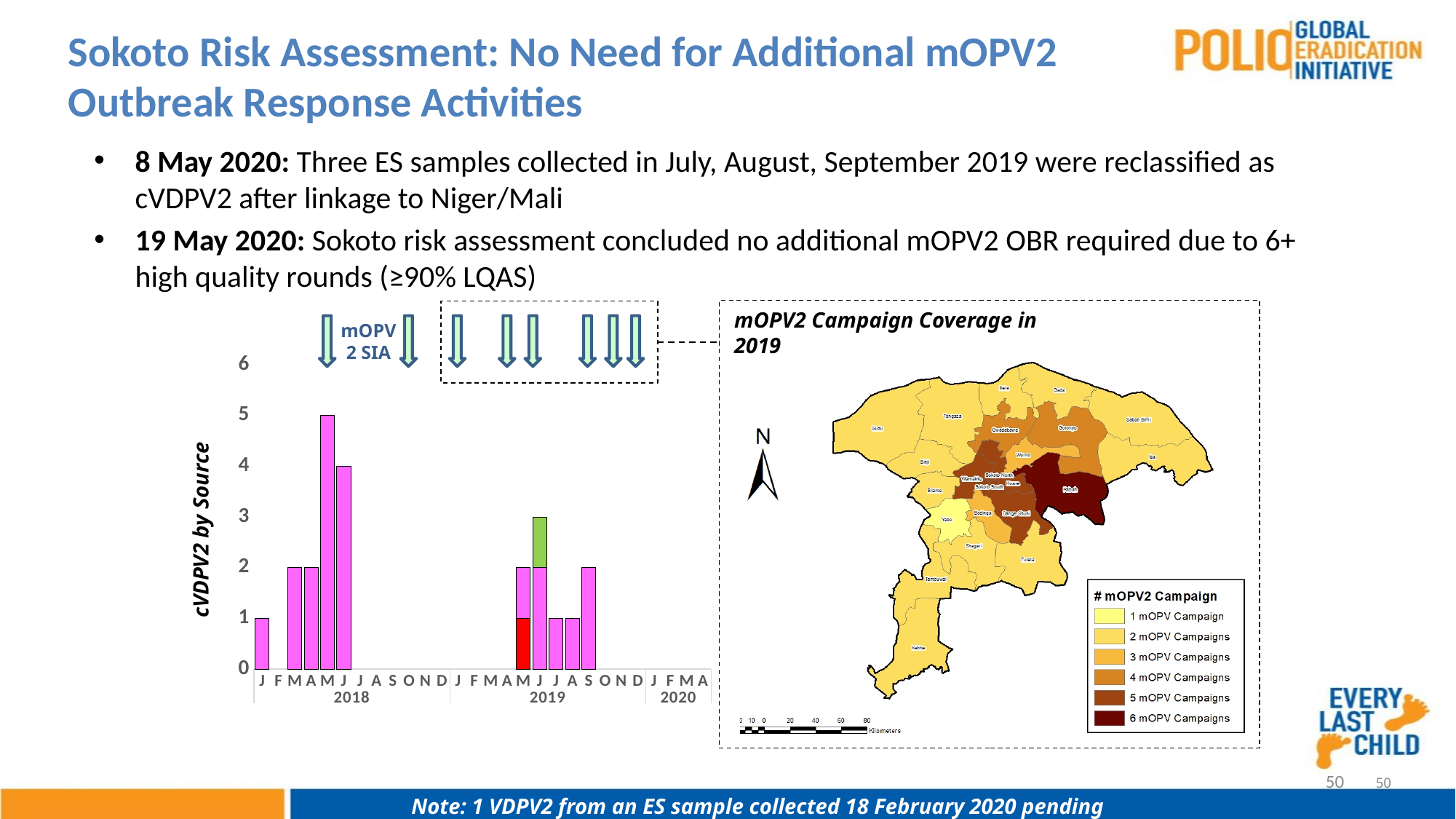
In the bar chart on the left, which month has the highest number of cVDPV2? May 2018 What is the title of the map on the right of the slide? mOPV2 Campaign Coverage in 2019 In the bar chart on the left, what is the total height of the stacked bar for June 2019? 3 In the bar chart on the left, what is the value for January 2018? 1 In the bar chart on the left, what is the value for May 2018? 5 What kind of chart is the chart on the left of the slide? bar chart In the bar chart on the left, which is larger: the value for June 2018 or the value for June 2019? June 2018 In the bar chart on the left, is the value for May 2018 greater or less than 3? greater In the bar chart on the left, what is the value for June 2018? 4 What is the y-axis title of the bar chart on the left? cVDPV2 by Source In the bar chart on the left, how many years are labelled along the x axis? 3 In the bar chart on the left, what is the difference between the values for May 2018 and June 2018? 1